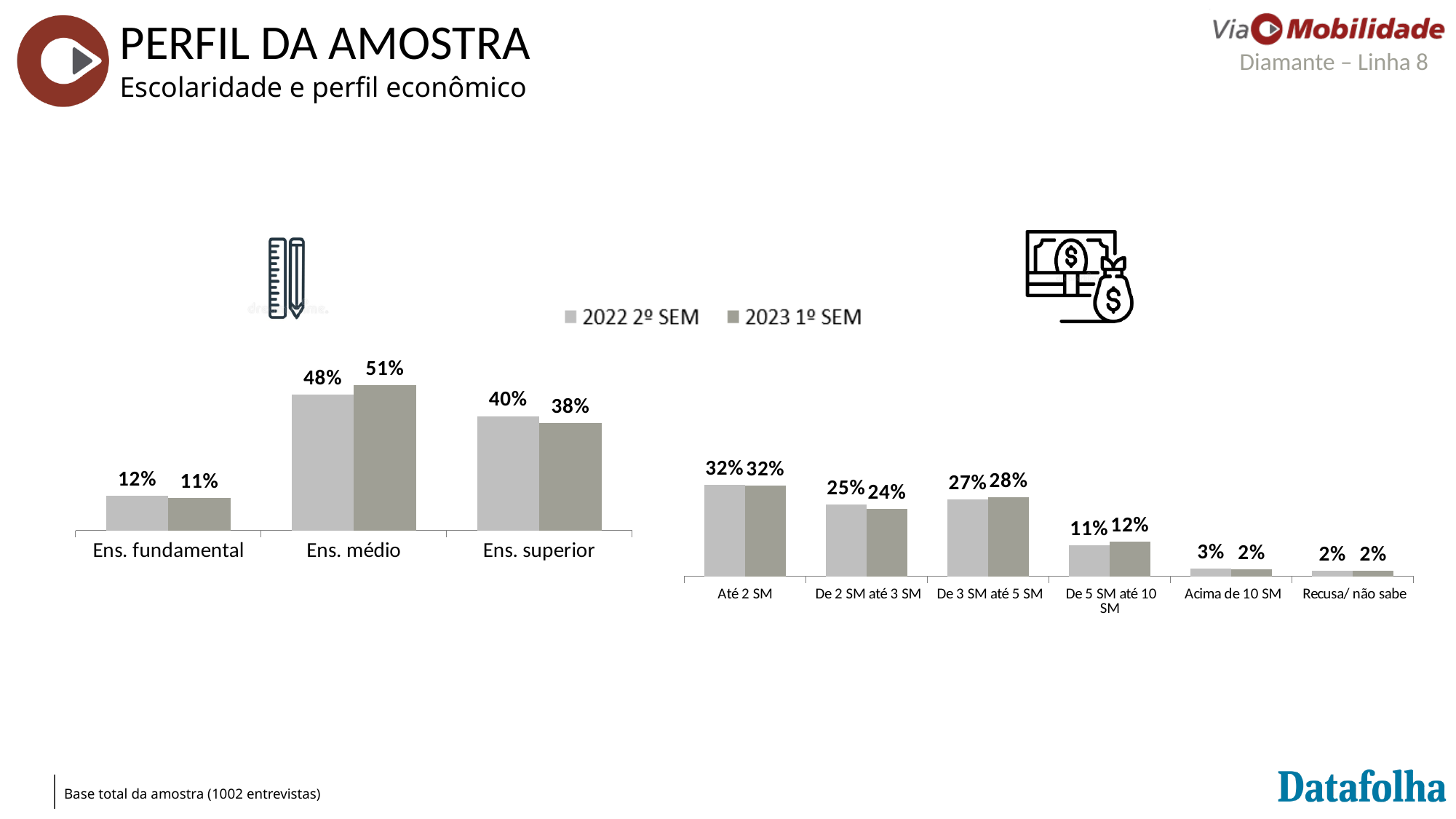
In the left chart (education level), what is the difference between the 2023 1º SEM and 2022 2º SEM values for Ens. médio? 3% In the left chart (education level), what is the value for Ens. superior in 2022 2º SEM? 40% In the right chart (income), which is larger for De 2 SM até 3 SM: the 2022 2º SEM value or the 2023 1º SEM value? 2022 2º SEM What type of chart is the left chart (education level)? Bar chart In the left chart (education level), what is the value for Ens. médio in 2023 1º SEM? 51% In the left chart (education level), which category has the highest value for 2022 2º SEM? Ens. médio How many series does the legend list? 2 In the left chart (education level), which category has the lowest value for 2023 1º SEM? Ens. fundamental In the right chart (income), how many categories are shown on the x axis? 6 In the right chart (income), what is the value for De 5 SM até 10 SM in 2022 2º SEM? 11% In the right chart (income), which category has the highest value for 2022 2º SEM? Até 2 SM In the right chart (income), what is the value for De 3 SM até 5 SM in 2023 1º SEM? 28%